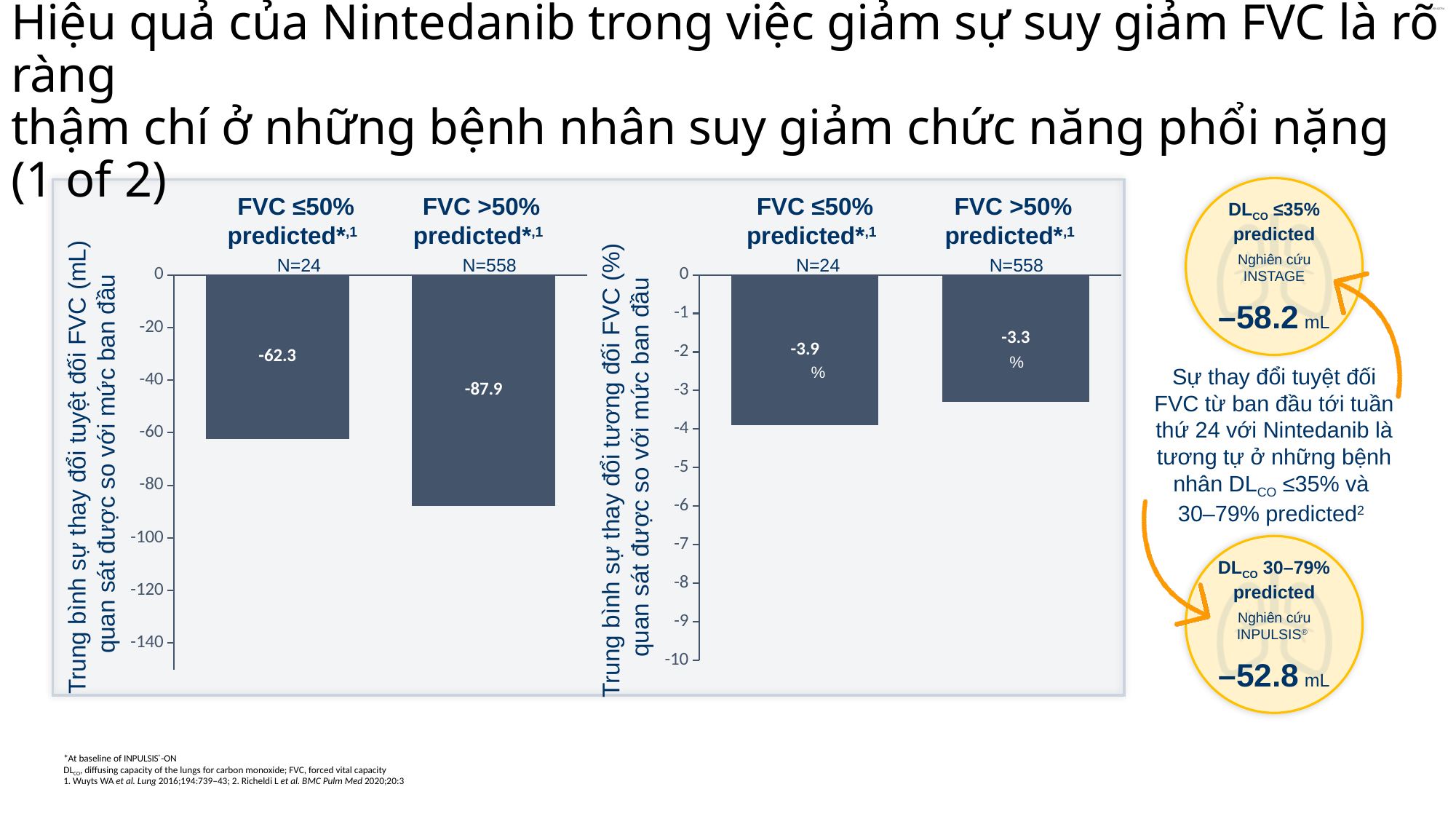
In the left chart (absolute change in FVC, mL), what is the value for FVC ≤50% predicted? -62.3 In the right chart (relative change in FVC, %), what is the value for FVC >50% predicted? -3.3% In the right chart (relative change in FVC, %), what is the value for FVC ≤50% predicted? -3.9% In the right chart (relative change in FVC, %), is the value for FVC ≤50% predicted above or below -4 on the axis? above In the left chart (absolute change in FVC, mL), what is the difference between the values for FVC >50% predicted and FVC ≤50% predicted? 25.6 In the left chart (absolute change in FVC, mL), which group has the larger decline? FVC >50% predicted In the right chart (relative change in FVC, %), what is the difference between the values for FVC ≤50% predicted and FVC >50% predicted? 0.6% How many bars are plotted in the left chart (absolute change in FVC, mL)? 2 In the left chart (absolute change in FVC, mL), what is the value for FVC >50% predicted? -87.9 What type of chart is the right chart (relative change in FVC, %)? Bar chart In the left chart (absolute change in FVC, mL), what is the sample size (N) for the FVC >50% predicted group? N=558 In the right chart (relative change in FVC, %), which group has the smaller decline? FVC >50% predicted